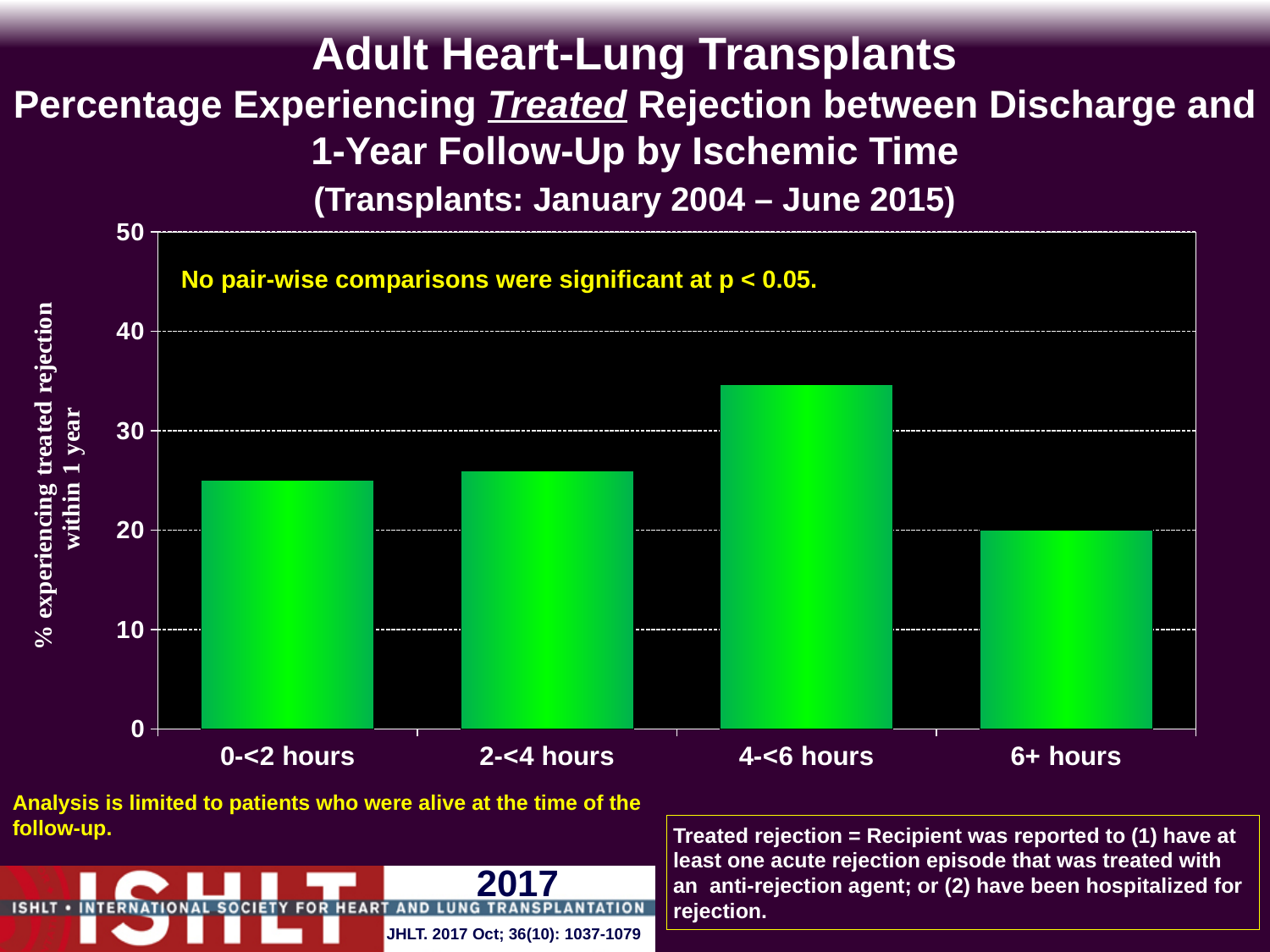
Which has a higher percentage experiencing treated rejection: 4-<6 hours or 6+ hours? 4-<6 hours Is the value for 2-<4 hours greater or less than 30? less Is the value for 4-<6 hours greater or less than 30? greater Which ischemic time category has the lowest percentage experiencing treated rejection within 1 year? 6+ hours What kind of chart is shown on the slide? bar chart How many ischemic time categories are shown on the x axis? 4 What is the label of the y axis? % experiencing treated rejection within 1 year Is the value for 0-<2 hours greater or less than 20? greater Which ischemic time category has the highest percentage experiencing treated rejection within 1 year? 4-<6 hours Which has a higher percentage experiencing treated rejection: 0-<2 hours or 4-<6 hours? 4-<6 hours What does the note inside the chart area say about pair-wise comparisons? No pair-wise comparisons were significant at p < 0.05.